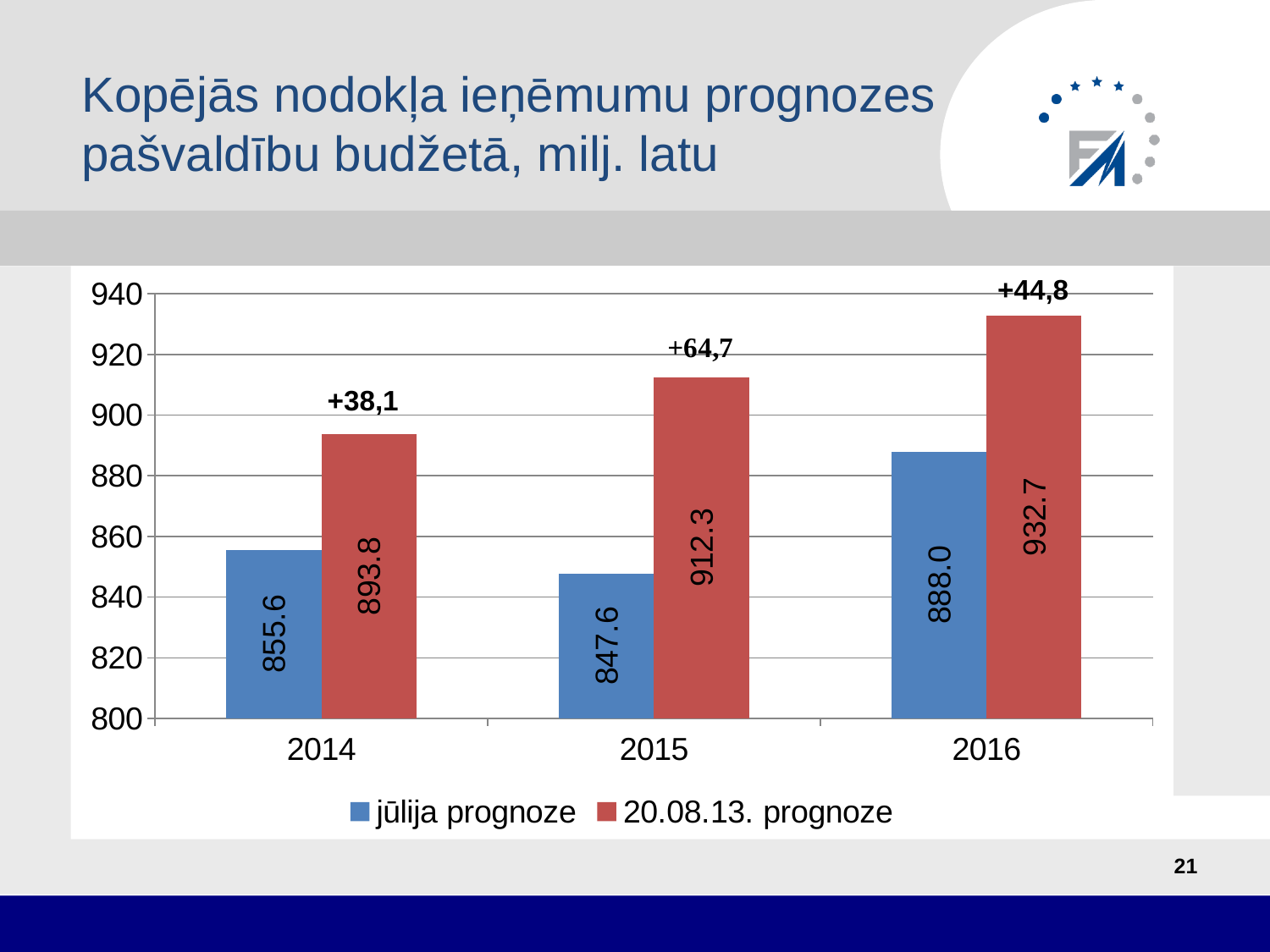
What kind of chart is shown on the slide? bar chart What is the value of the 20.08.13. prognoze series for 2016? 932.7 Which is larger for 2015: the jūlija prognoze value or the 20.08.13. prognoze value? 20.08.13. prognoze Is the jūlija prognoze value for 2016 greater or less than 880? greater Do the 20.08.13. prognoze values rise or fall from 2014 to 2016? rise What is the difference between the 20.08.13. prognoze and the jūlija prognoze values for 2016? 44.7 How many years are shown on the x axis? 3 Which year has the lowest value for the jūlija prognoze series? 2015 What is the value of the jūlija prognoze series for 2014? 855.6 Which year has the highest value for the 20.08.13. prognoze series? 2016 What is the value of the 20.08.13. prognoze series for 2015? 912.3 How many series does the legend list? 2